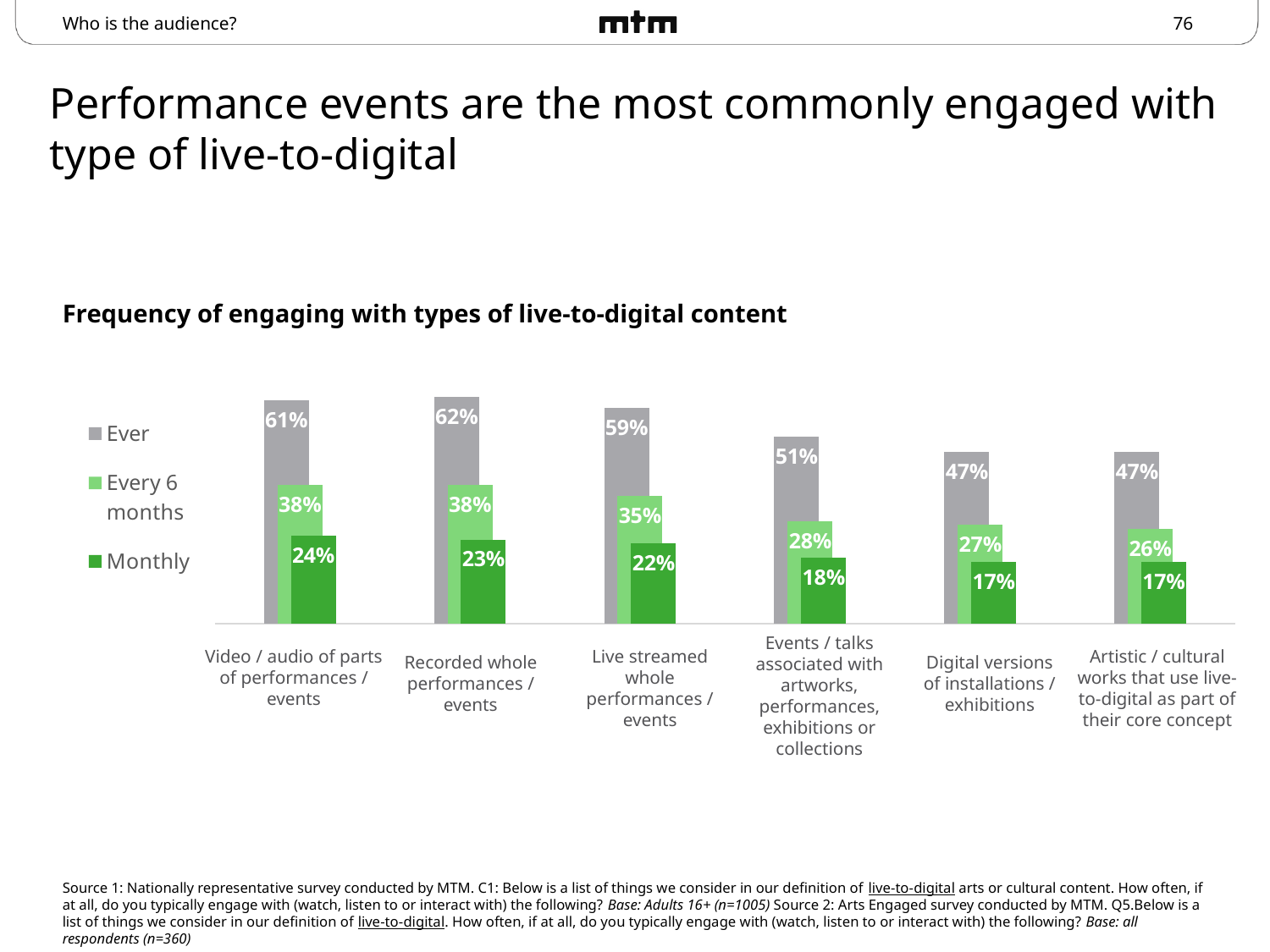
Which category has the highest 'Ever' value? Recorded whole performances / events How many categories are shown on the x axis? 6 What is the title of the chart? Frequency of engaging with types of live-to-digital content How many series does the legend list? 3 What kind of chart is shown? Bar chart What is the 'Monthly' value for Events / talks associated with artworks, performances, exhibitions or collections? 18% Which category has the highest 'Monthly' value? Video / audio of parts of performances / events What is the 'Ever' value for Recorded whole performances / events? 62% Do the 'Ever' values generally rise or fall from left to right across the categories? Fall What is the difference between the 'Ever' and 'Monthly' values for Digital versions of installations / exhibitions? 30% Which is larger: the 'Every 6 months' value for Video / audio of parts of performances / events or for Artistic / cultural works that use live-to-digital as part of their core concept? Video / audio of parts of performances / events What is the 'Every 6 months' value for Live streamed whole performances / events? 35%